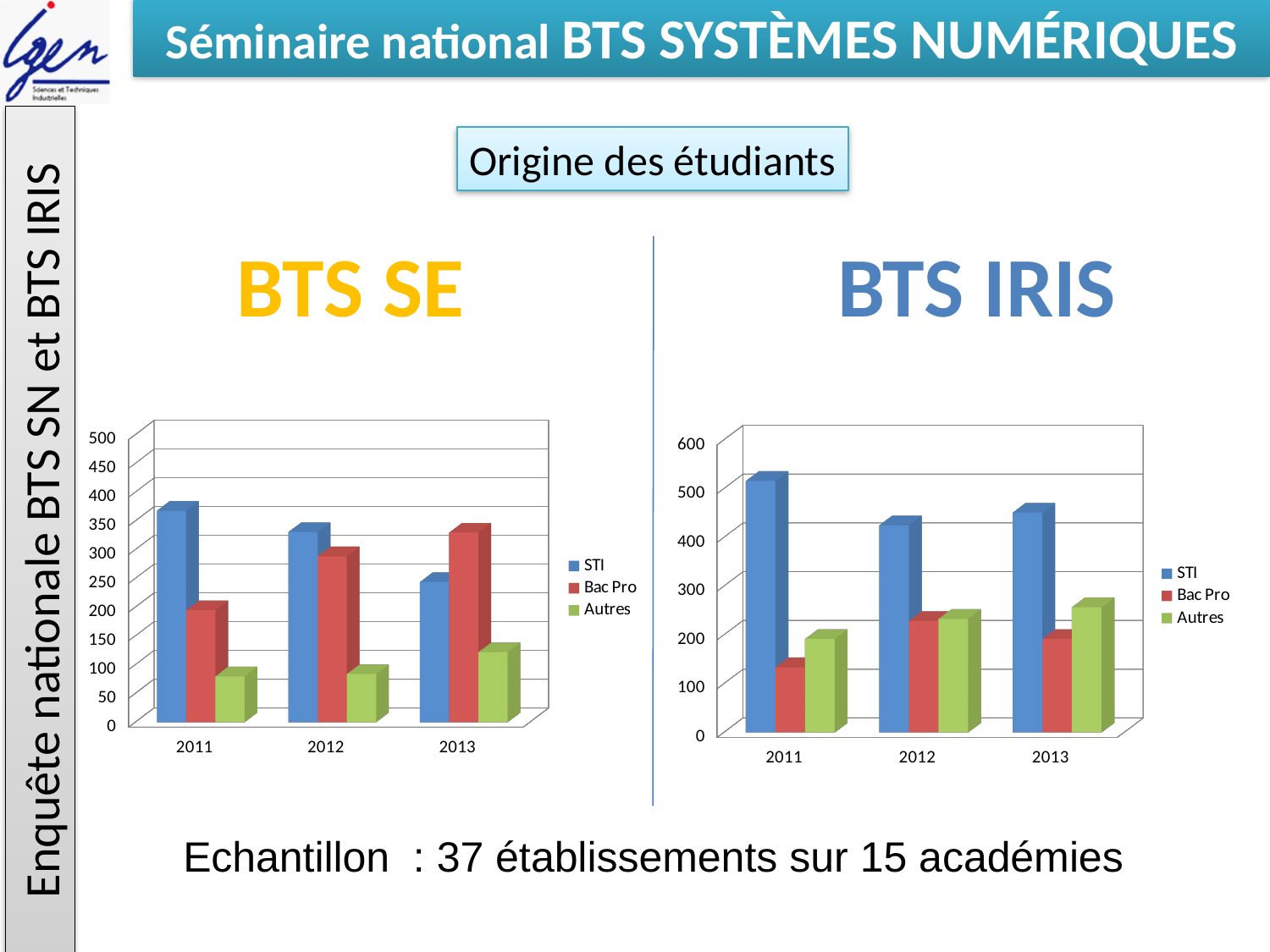
In the BTS SE chart, does the STI value rise or fall from 2011 to 2013? fall In the BTS SE chart, is the STI value for 2011 greater or less than 300? greater How many years are shown on the x axis of the BTS SE chart? 3 In the BTS IRIS chart, which year has the highest STI value? 2011 In the BTS SE chart, which series is larger in 2013, STI or Bac Pro? Bac Pro Which series is shown in green in both charts? Autres In the BTS SE chart, is the Autres value for 2012 greater or less than 100? less In the BTS IRIS chart, is the STI value for 2011 greater or less than 500? greater In the BTS SE chart, does the Bac Pro value rise or fall from 2011 to 2013? rise How many series does the legend of the BTS IRIS chart list? 3 What kind of chart is the BTS SE chart? bar chart